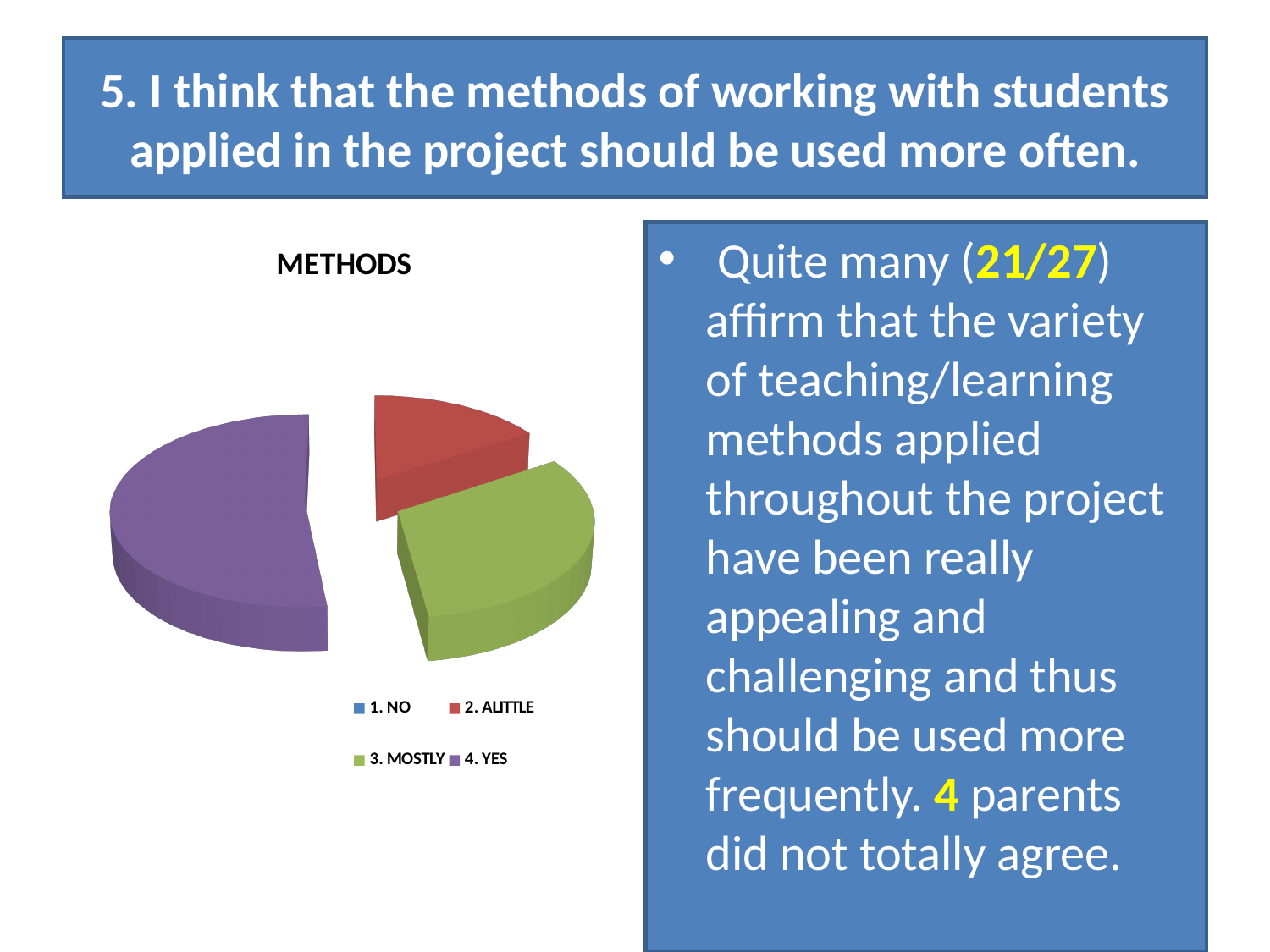
What kind of chart is shown on the slide? pie chart What is the title of the chart? METHODS Which slice is larger, 3. MOSTLY or 2. ALITTLE? 3. MOSTLY Which slice is larger, 4. YES or 2. ALITTLE? 4. YES Which category has the largest slice of the pie? 4. YES Which slice is larger, 4. YES or 3. MOSTLY? 4. YES How many entries does the chart's legend list? 4 What colour is the slice for 4. YES? purple